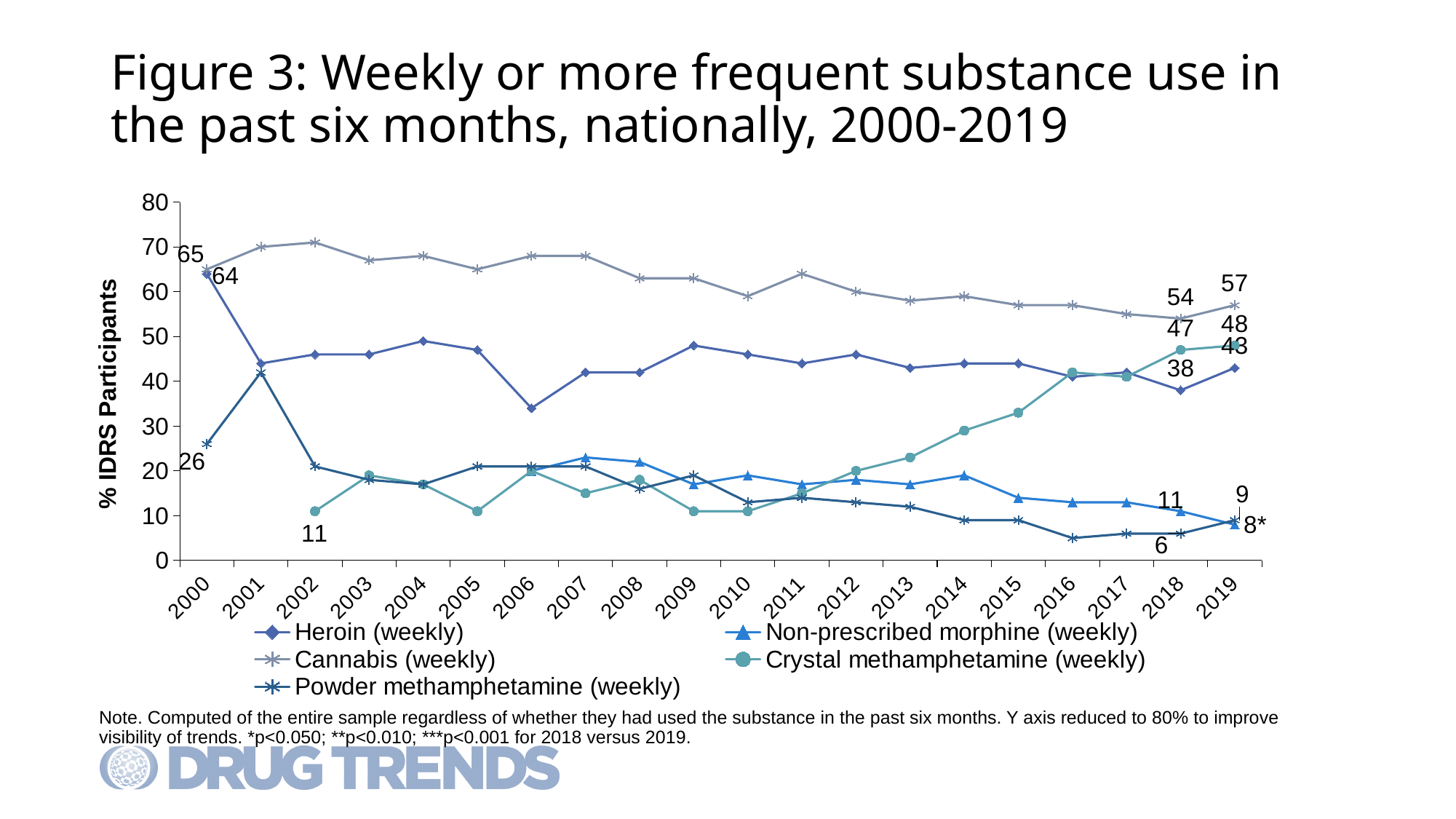
What is the value for Cannabis (weekly) in 2000? 65 What is the value for Powder methamphetamine (weekly) in 2000? 26 By how much did the Cannabis (weekly) value fall from 2000 to 2019? 8 Which series has the highest value in 2019? Cannabis (weekly) How many years are shown on the x axis? 20 What is the value for Crystal methamphetamine (weekly) in 2018? 47 What is the value for Heroin (weekly) in 2018? 38 What is the value for Cannabis (weekly) in 2019? 57 What is the value for Heroin (weekly) in 2000? 64 What kind of chart is shown on the slide? line chart How many series does the legend list? 5 Is the value for Cannabis (weekly) in 2002 greater or less than 60? greater